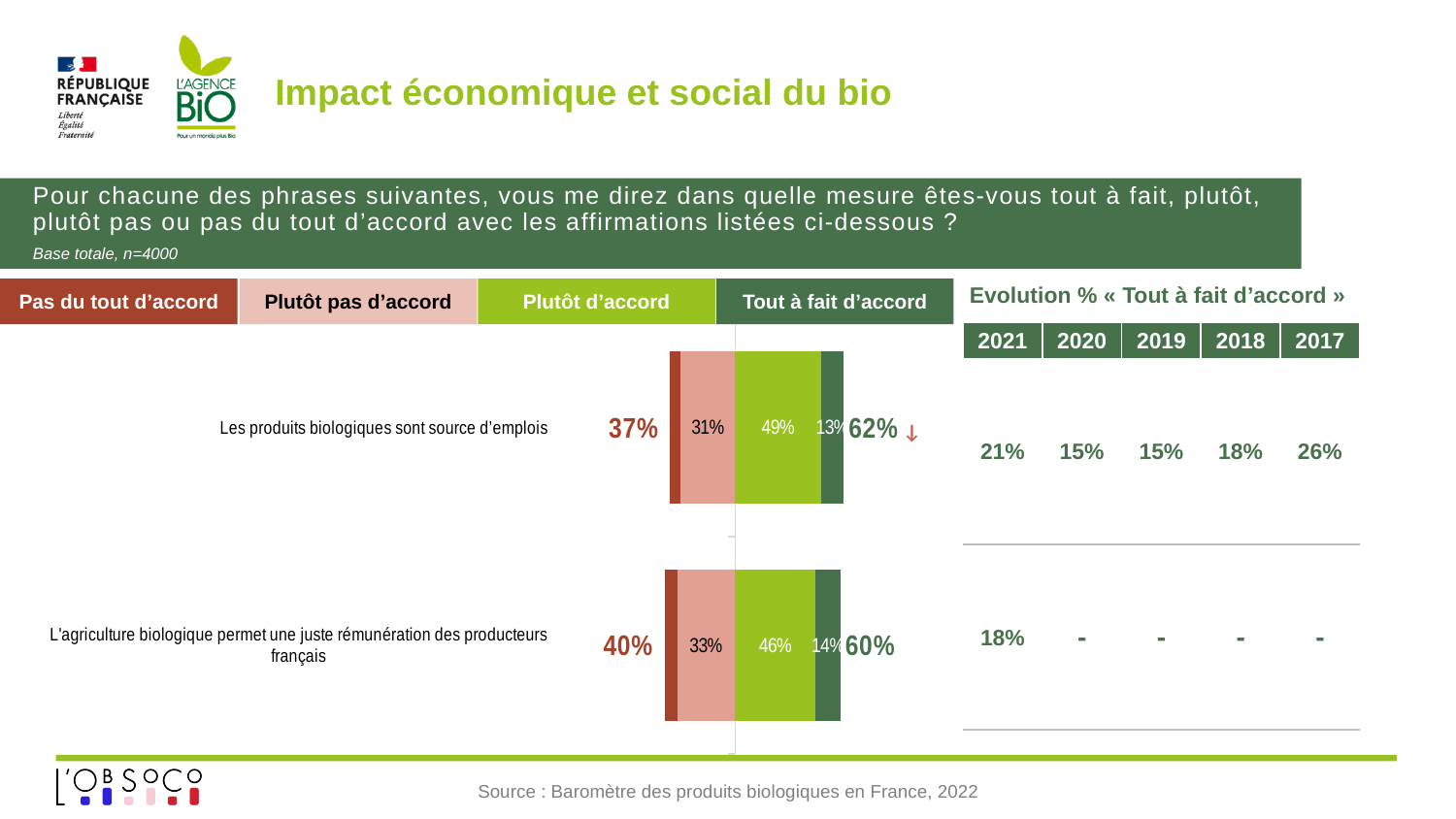
What is the total disagreement shown for 'L'agriculture biologique permet une juste rémunération des producteurs français'? 40% What is the difference between the 'Plutôt pas d'accord' values of the two statements? 2% How many response categories does the legend list? 4 In the evolution table, what was the 'Tout à fait d'accord' share for 'Les produits biologiques sont source d'emplois' in 2017? 26% What is the 'Plutôt pas d'accord' value for 'L'agriculture biologique permet une juste rémunération des producteurs français'? 33% Which statement has the higher 'Plutôt d'accord' value? Les produits biologiques sont source d'emplois What is the total agreement (Plutôt d'accord + Tout à fait d'accord) shown for 'Les produits biologiques sont source d'emplois'? 62% What is the 'Plutôt d'accord' value for 'Les produits biologiques sont source d'emplois'? 49% In the evolution table, which year shows the lowest 'Tout à fait d'accord' share for 'Les produits biologiques sont source d'emplois'? 2020 and 2019 (15%) What kind of chart is shown on the slide? stacked bar chart What is the 'Tout à fait d'accord' value for 'L'agriculture biologique permet une juste rémunération des producteurs français'? 14% How many statements (categories) are plotted in the bar chart? 2